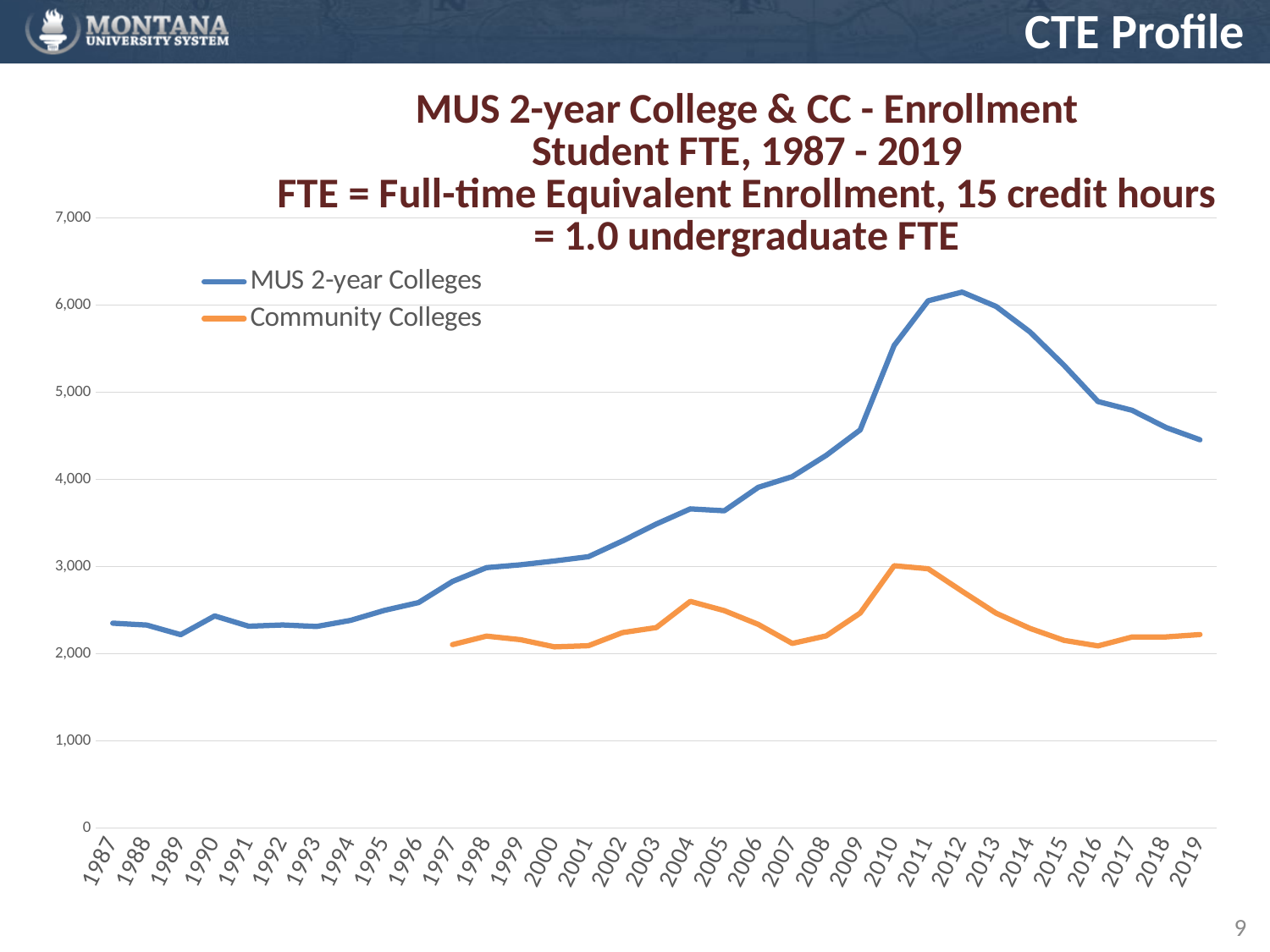
How many series does the legend list? 2 How many years are shown on the x axis? 33 Is the value for MUS 2-year Colleges in 2019 greater or less than 5,000? less In which year does the Community Colleges line reach its highest value? 2010 In which year does the MUS 2-year Colleges line reach its highest value? 2012 Is the value for MUS 2-year Colleges in 2012 greater or less than 6,000? greater Is the value for Community Colleges in 2016 greater or less than 3,000? less Does the MUS 2-year Colleges line rise or fall from 2012 to 2019? Fall What kind of chart is shown on the slide? Line chart Which two series are listed in the legend? MUS 2-year Colleges and Community Colleges In 2012, which series has the larger value, MUS 2-year Colleges or Community Colleges? MUS 2-year Colleges Which colour is used for the Community Colleges line? Orange